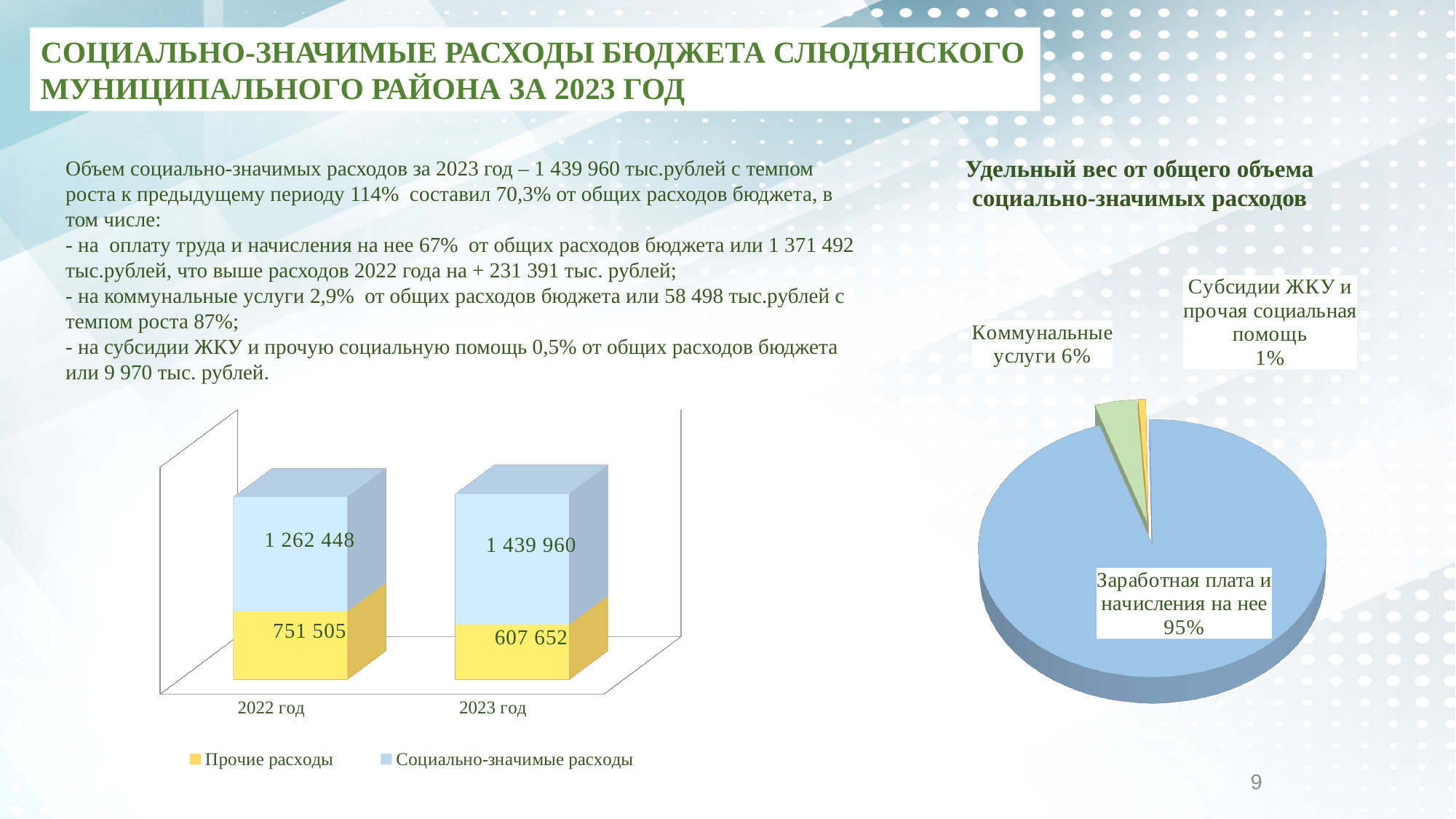
On the pie chart titled 'Удельный вес от общего объема социально-значимых расходов', what share does Заработная плата и начисления на нее have? 95% On the pie chart titled 'Удельный вес от общего объема социально-значимых расходов', how many slices are there? 3 On the bar chart at the bottom left, which year has the larger value for Прочие расходы, 2022 год or 2023 год? 2022 год On the bar chart at the bottom left, how many series does the legend list? 2 On the bar chart at the bottom left, what is the value of Прочие расходы for 2023 год? 607 652 On the bar chart at the bottom left, what is the value of Социально-значимые расходы for 2023 год? 1 439 960 On the bar chart at the bottom left, what is the value of Прочие расходы for 2022 год? 751 505 What kind of chart is shown at the bottom left of the slide? Stacked bar chart On the bar chart at the bottom left, what is the total of the stacked bar for 2022 год? 2 013 953 On the bar chart at the bottom left, what is the total of the stacked bar for 2023 год? 2 047 612 On the bar chart at the bottom left, by how much did Социально-значимые расходы increase from 2022 год to 2023 год? 177 512 On the pie chart titled 'Удельный вес от общего объема социально-значимых расходов', which category has the smallest share? Субсидии ЖКУ и прочая социальная помощь